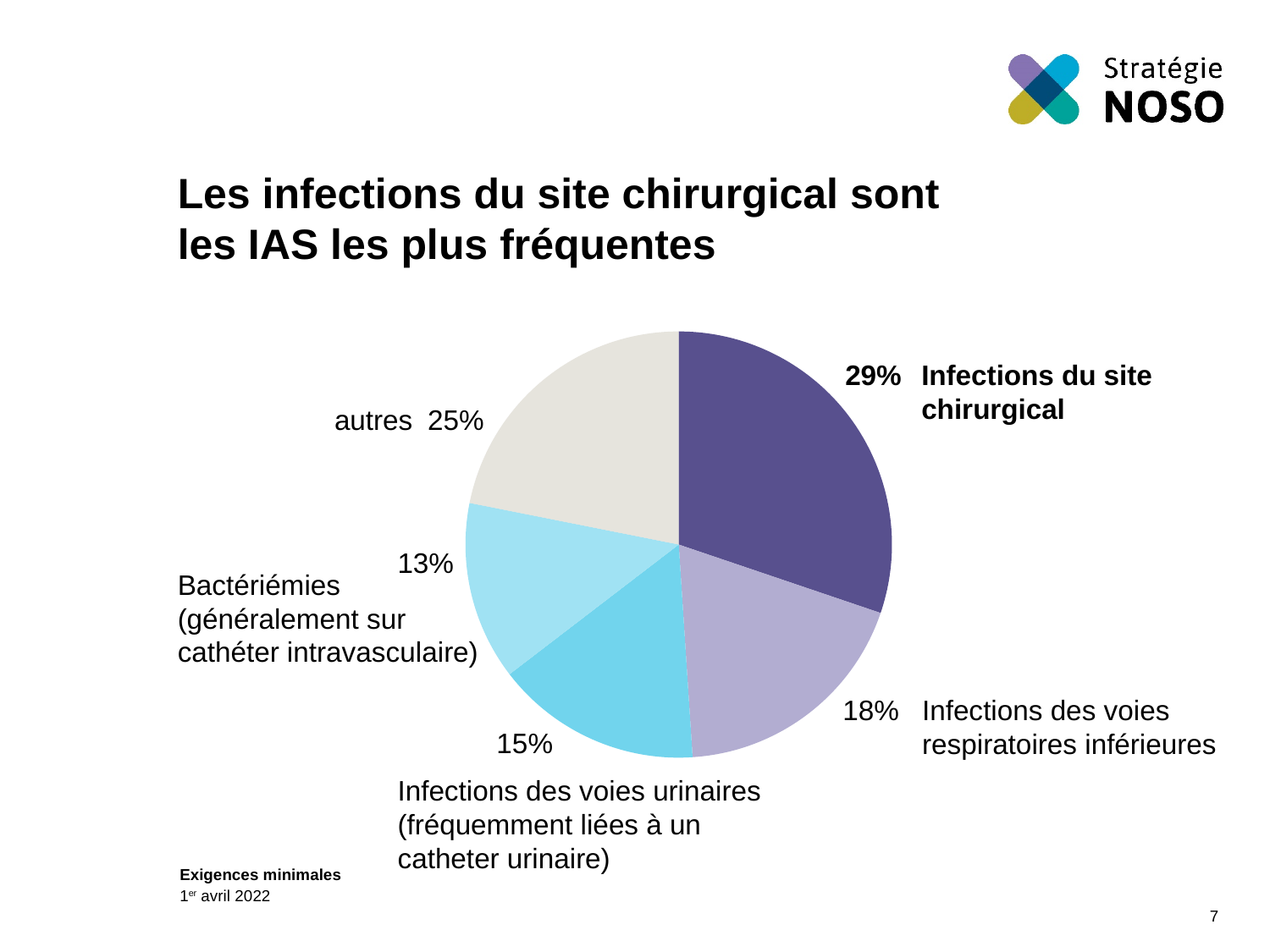
What percentage is shown for "Bactériémies"? 13% What is the title of the slide containing the pie chart? Les infections du site chirurgical sont les IAS les plus fréquentes What is the difference in percentage points between "Infections du site chirurgical" and "autres"? 4 How many slices does the pie chart have? 5 Which category has the smallest share of the pie? Bactériémies What share of the pie is labelled "Infections du site chirurgical"? 29% What percentage is shown for "Infections des voies respiratoires inférieures"? 18% What percentage is shown for "Infections des voies urinaires"? 15% What percentage is shown for "autres"? 25% Which is larger: the share for "Infections des voies respiratoires inférieures" or the share for "Infections des voies urinaires"? Infections des voies respiratoires inférieures What kind of chart is shown on the slide? pie chart Which category has the largest share of the pie? Infections du site chirurgical